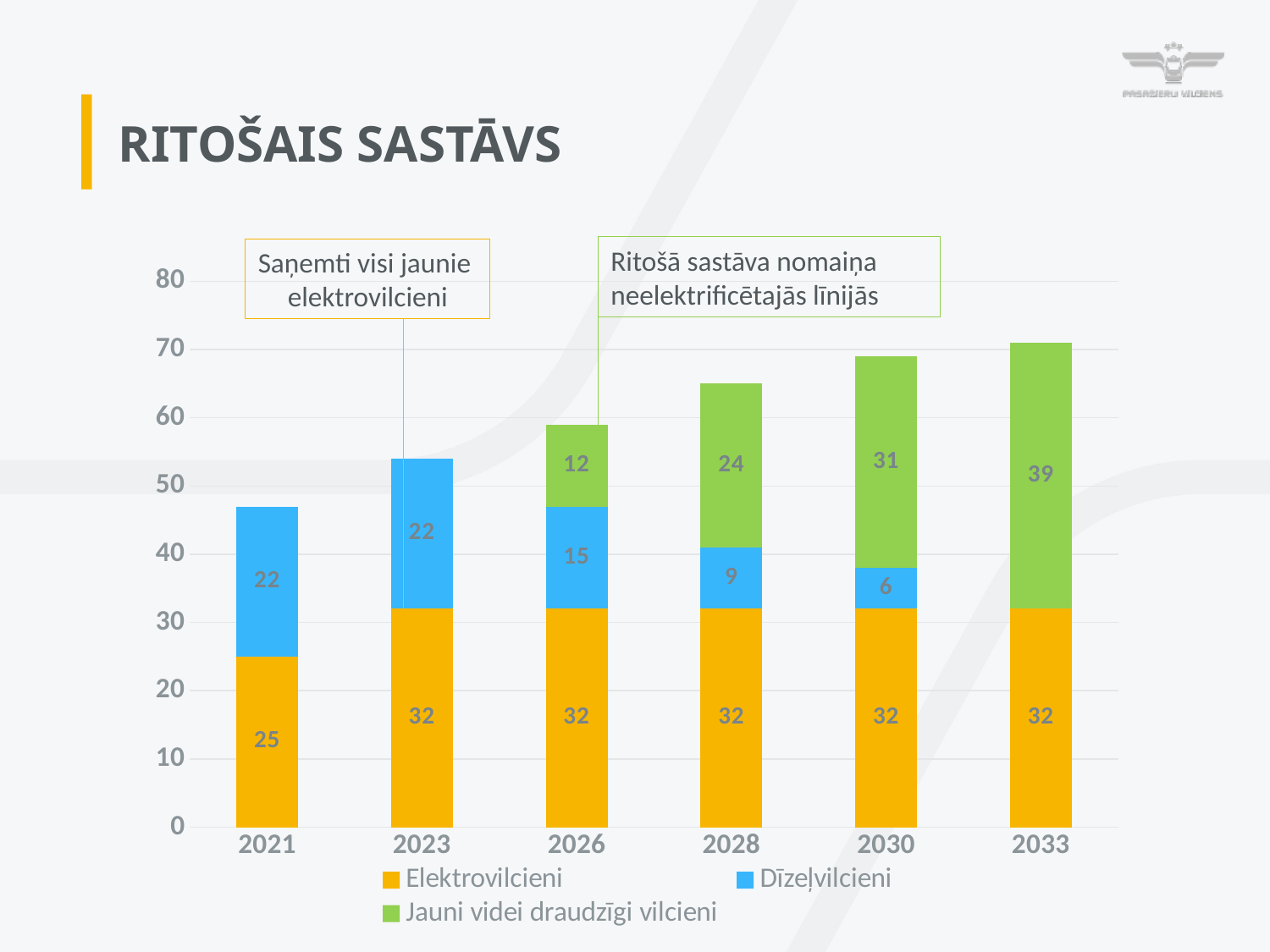
What is the value for Dīzeļvilcieni in 2026? 15 What is the value for Jauni videi draudzīgi vilcieni in 2033? 39 What is the total of the stacked bar for 2026? 59 In which year is the value for Dīzeļvilcieni lowest among the years where it is shown? 2030 What is the difference between the Jauni videi draudzīgi vilcieni values for 2030 and 2028? 7 In which year is the value for Jauni videi draudzīgi vilcieni highest? 2033 How many series does the legend list? 3 Does the total height of the bars rise or fall from 2021 to 2033? rise What is the value for Elektrovilcieni in 2021? 25 How many years are shown on the x axis? 6 What type of chart is shown on the slide? stacked bar chart Which is larger in 2028: the Dīzeļvilcieni value or the Jauni videi draudzīgi vilcieni value? Jauni videi draudzīgi vilcieni